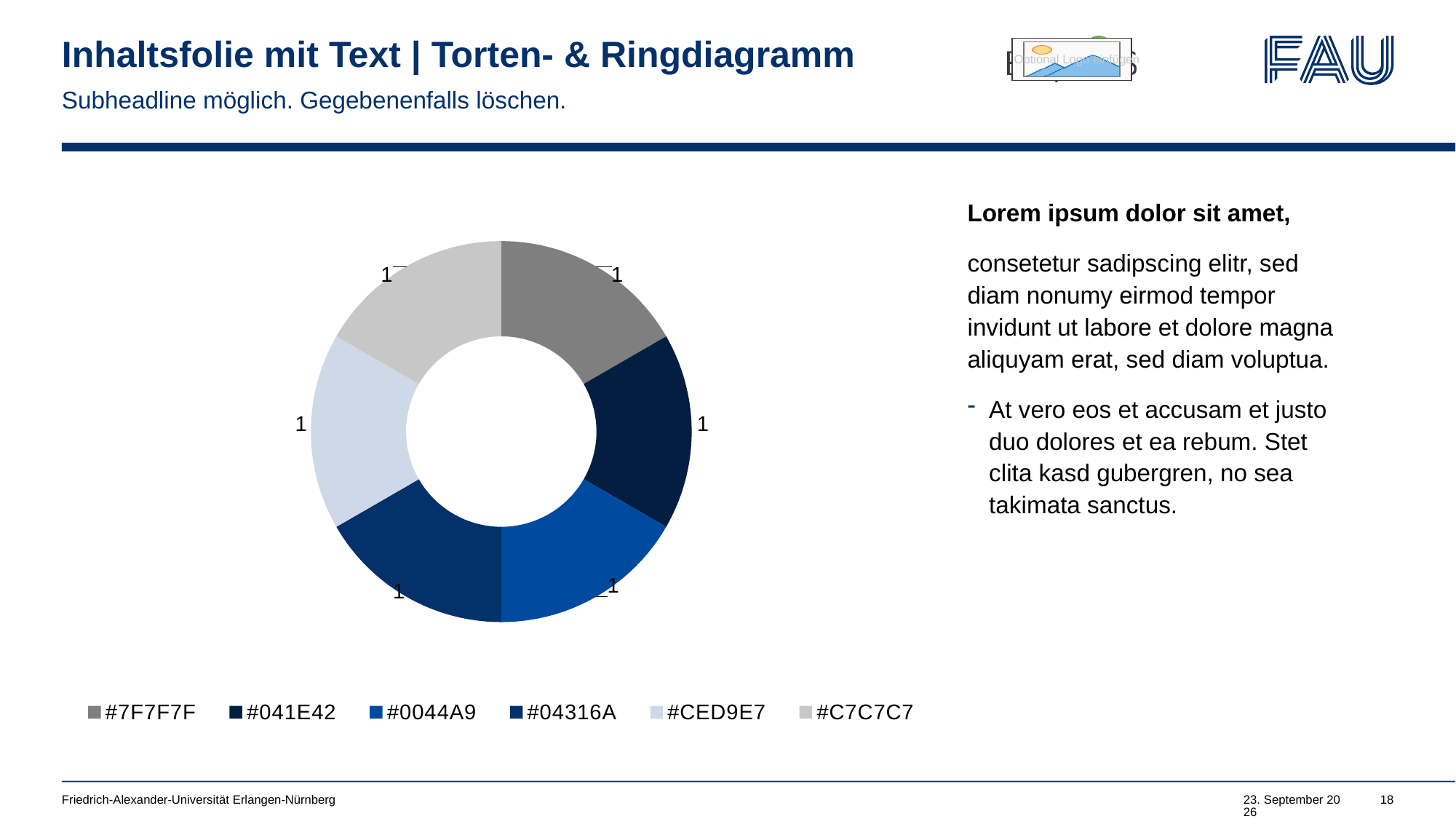
What is the value of the #7F7F7F slice? 1 Which legend entry is listed last? #C7C7C7 How many entries does the legend list? 6 Is the value of the #04316A slice greater or less than 2? less What is the value of the #CED9E7 slice? 1 What is the value of the #041E42 slice? 1 What kind of chart is shown on the slide? doughnut chart What is the difference between the values of the #0044A9 and #C7C7C7 slices? 0 What is the total of all slice values in the doughnut chart? 6 Which legend entry is listed first? #7F7F7F How many slices does the doughnut chart have? 6